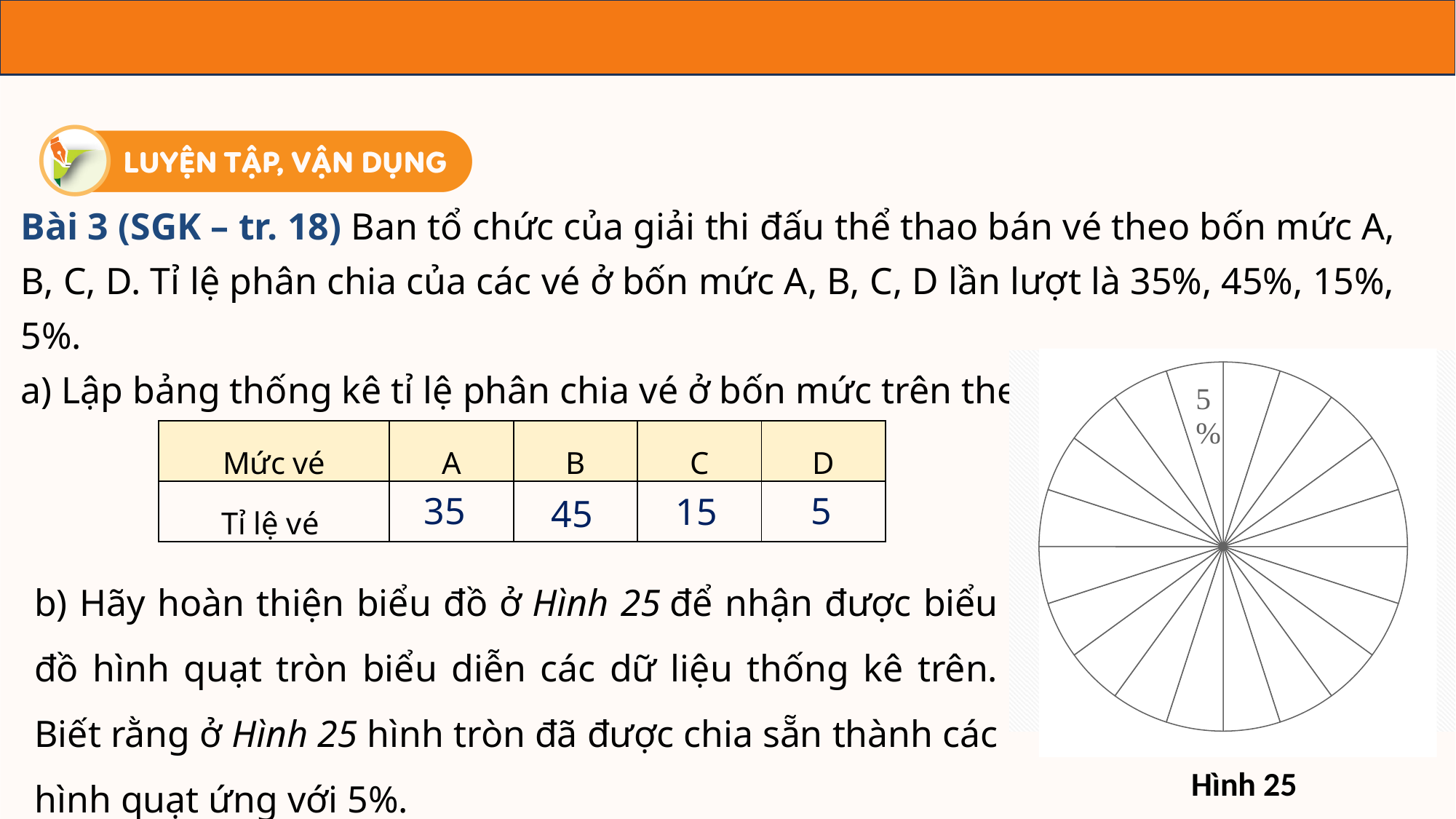
Into how many equal sectors is the circle in Hình 25 divided? 20 What percentage label is printed inside one of the sectors of the circle in Hình 25? 5% Does the circle chart in Hình 25 have any coloured or filled slices? No What kind of chart is shown in Hình 25? pie chart What share of the whole circle does each sector in Hình 25 represent? 5% What is the caption printed below the circle chart on the slide? Hình 25